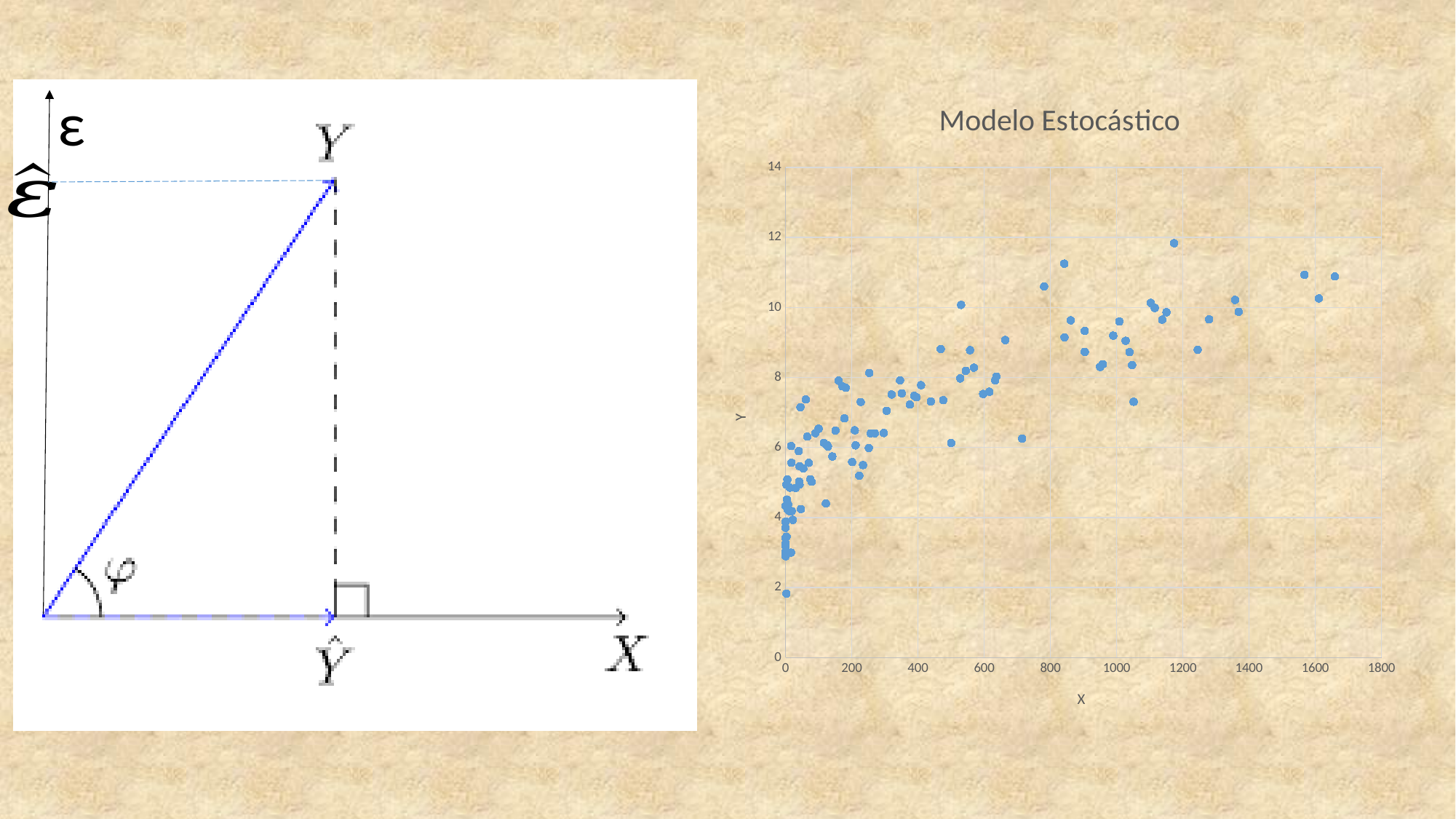
What kind of chart is the 'Modelo Estocástico' chart? scatter chart In the 'Modelo Estocástico' chart, is the highest plotted Y value greater or less than 13? less In the 'Modelo Estocástico' chart, what is the highest tick value shown on the horizontal axis? 1800 In the 'Modelo Estocástico' chart, what is the label of the horizontal axis? X What is the title of the chart on the right side of the slide? Modelo Estocástico In the 'Modelo Estocástico' chart, do the Y values generally rise or fall as X increases? rise In the 'Modelo Estocástico' chart, what is the highest tick value shown on the vertical axis? 14 In the 'Modelo Estocástico' chart, are the points with X greater than 1400 above or below a Y value of 8? above In the 'Modelo Estocástico' chart, is the lowest plotted Y value greater or less than 3? less